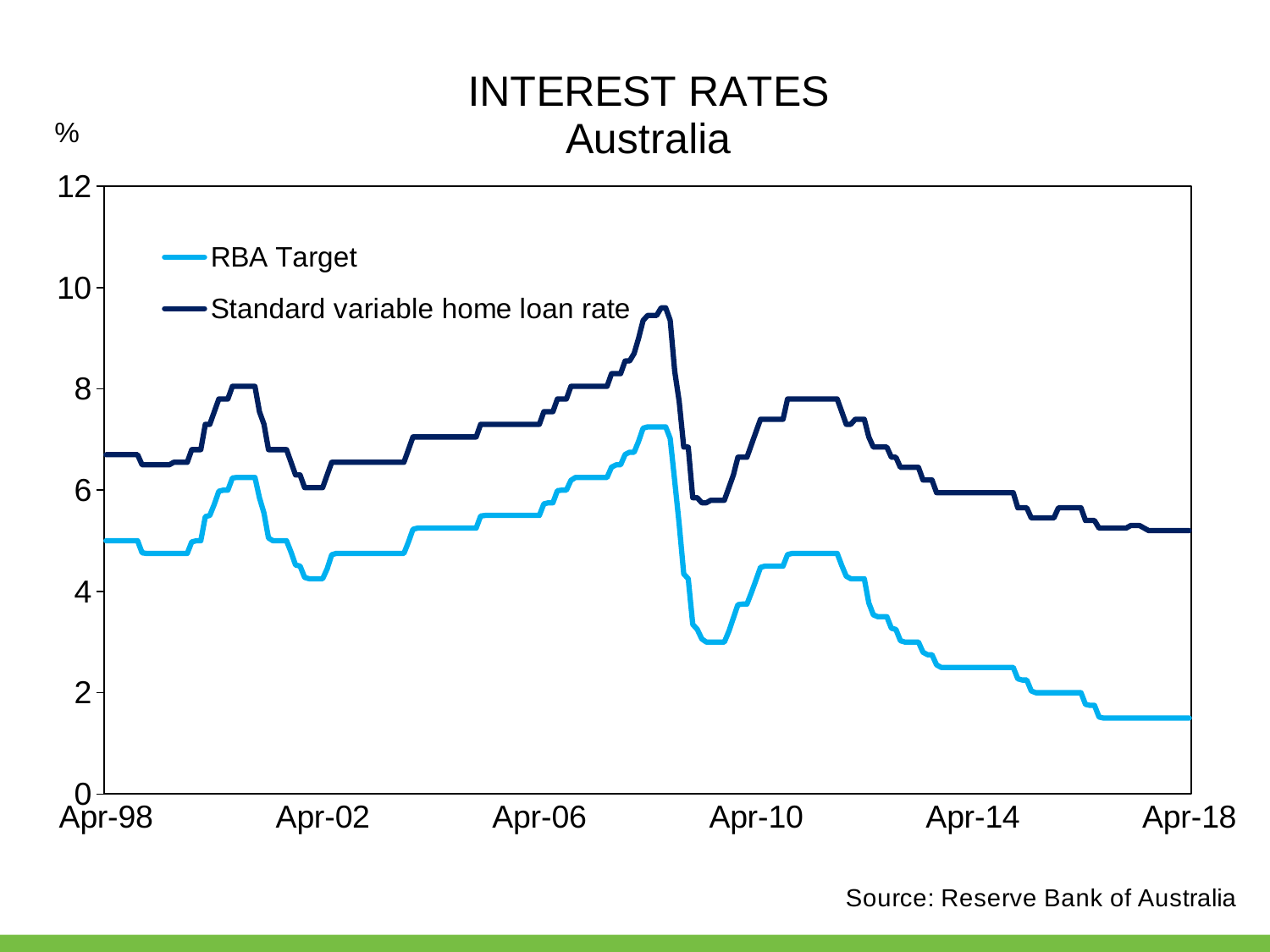
How many series does the legend list? 2 Which series reaches the highest value on the chart? Standard variable home loan rate Is the peak value of the Standard variable home loan rate greater or less than 8? greater Which series is higher across the whole period, RBA Target or Standard variable home loan rate? Standard variable home loan rate Does the RBA Target rise or fall between Apr-10 and Apr-18? fall What is the title of the chart? INTEREST RATES Australia What is the source cited for the chart? Reserve Bank of Australia Is the value of the RBA Target at Apr-98 greater or less than 4? greater Is the value of the Standard variable home loan rate at Apr-10 greater or less than 6? greater What kind of chart is shown on the slide? Line chart